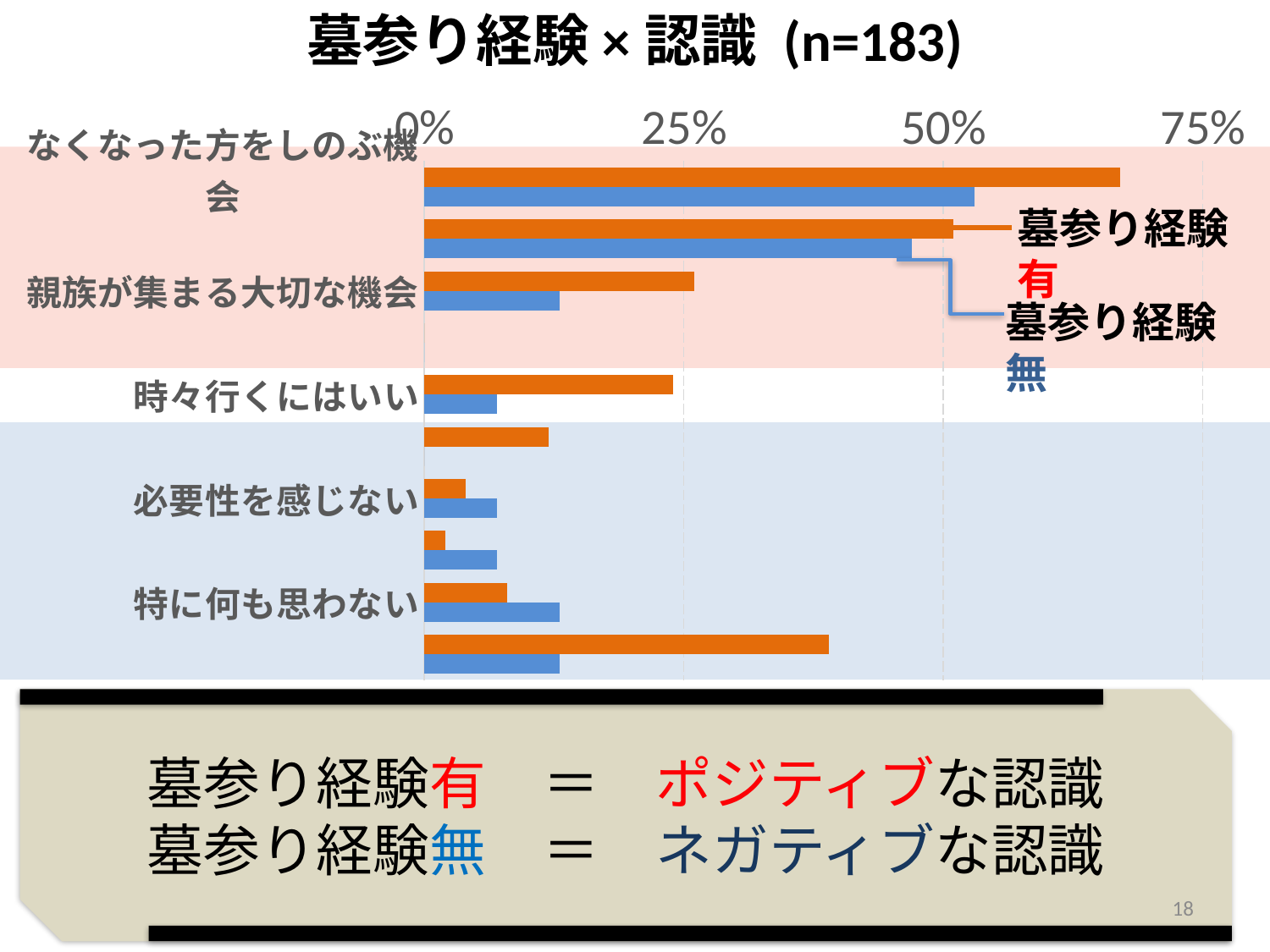
In the category 親族が集まる大切な機会, which series has the larger value, 墓参り経験有 or 墓参り経験無? 墓参り経験有 Is the value for 墓参り経験無 in the category 特に何も思わない greater or less than 25%? less In the category 特に何も思わない, which series has the larger value, 墓参り経験有 or 墓参り経験無? 墓参り経験無 How many series does the chart's legend list? 2 In the category なくなった方をしのぶ機会, which series has the larger value, 墓参り経験有 or 墓参り経験無? 墓参り経験有 What is the title of the chart? 墓参り経験×認識 (n=183) Which labeled category has the highest value for 墓参り経験有? なくなった方をしのぶ機会 What kind of chart is shown on the slide? bar chart Is the value for 墓参り経験有 in the category 親族が集まる大切な機会 greater or less than 50%? less Is the value for 墓参り経験無 in the category なくなった方をしのぶ機会 greater or less than 50%? greater What are the two series named in the legend? 墓参り経験有, 墓参り経験無